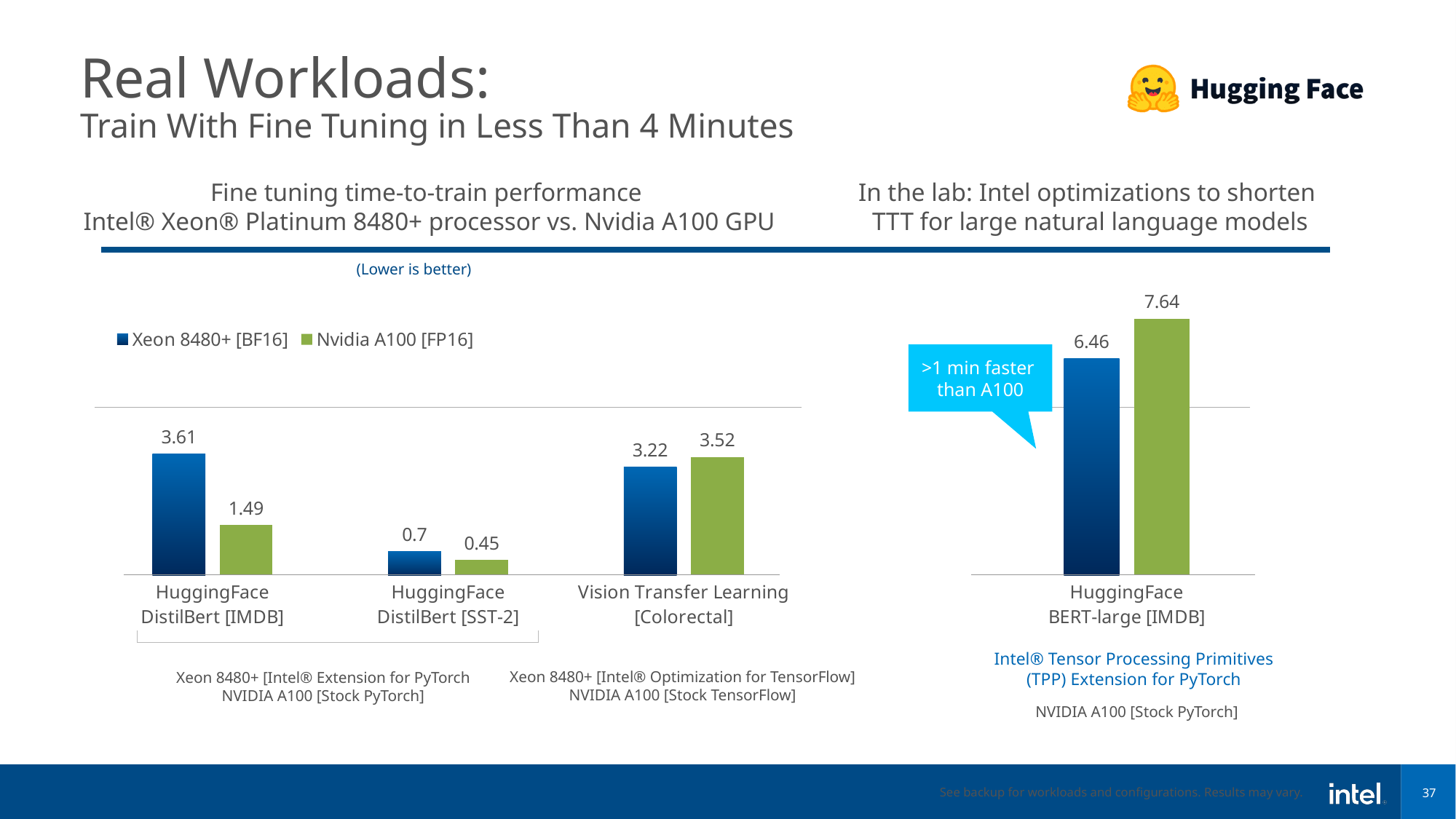
On the right chart (In the lab: Intel optimizations to shorten TTT), what is the value of the green Nvidia A100 bar for HuggingFace BERT-large [IMDB]? 7.64 On the left chart (Fine tuning time-to-train performance), which category has the highest Xeon 8480+ [BF16] value? HuggingFace DistilBert [IMDB] On the left chart (Fine tuning time-to-train performance), which category has the lowest Nvidia A100 [FP16] value? HuggingFace DistilBert [SST-2] On the left chart (Fine tuning time-to-train performance), how many categories are shown on the x axis? 3 What kind of chart is the right chart (In the lab: Intel optimizations to shorten TTT)? Bar chart On the left chart (Fine tuning time-to-train performance), what is the value for Xeon 8480+ [BF16] on HuggingFace DistilBert [IMDB]? 3.61 On the left chart (Fine tuning time-to-train performance), how many series does the legend list? 2 On the left chart (Fine tuning time-to-train performance), which is larger for Vision Transfer Learning [Colorectal]: Xeon 8480+ [BF16] or Nvidia A100 [FP16]? Nvidia A100 [FP16] On the left chart (Fine tuning time-to-train performance), what is the value for Xeon 8480+ [BF16] on Vision Transfer Learning [Colorectal]? 3.22 On the left chart (Fine tuning time-to-train performance), what is the difference between the Xeon 8480+ [BF16] and Nvidia A100 [FP16] values for HuggingFace DistilBert [IMDB]? 2.12 On the left chart (Fine tuning time-to-train performance), what is the value for Nvidia A100 [FP16] on HuggingFace DistilBert [SST-2]? 0.45 On the right chart (In the lab: Intel optimizations to shorten TTT), what is the difference between the Nvidia A100 value and the Xeon 8480+ value for HuggingFace BERT-large [IMDB]? 1.18